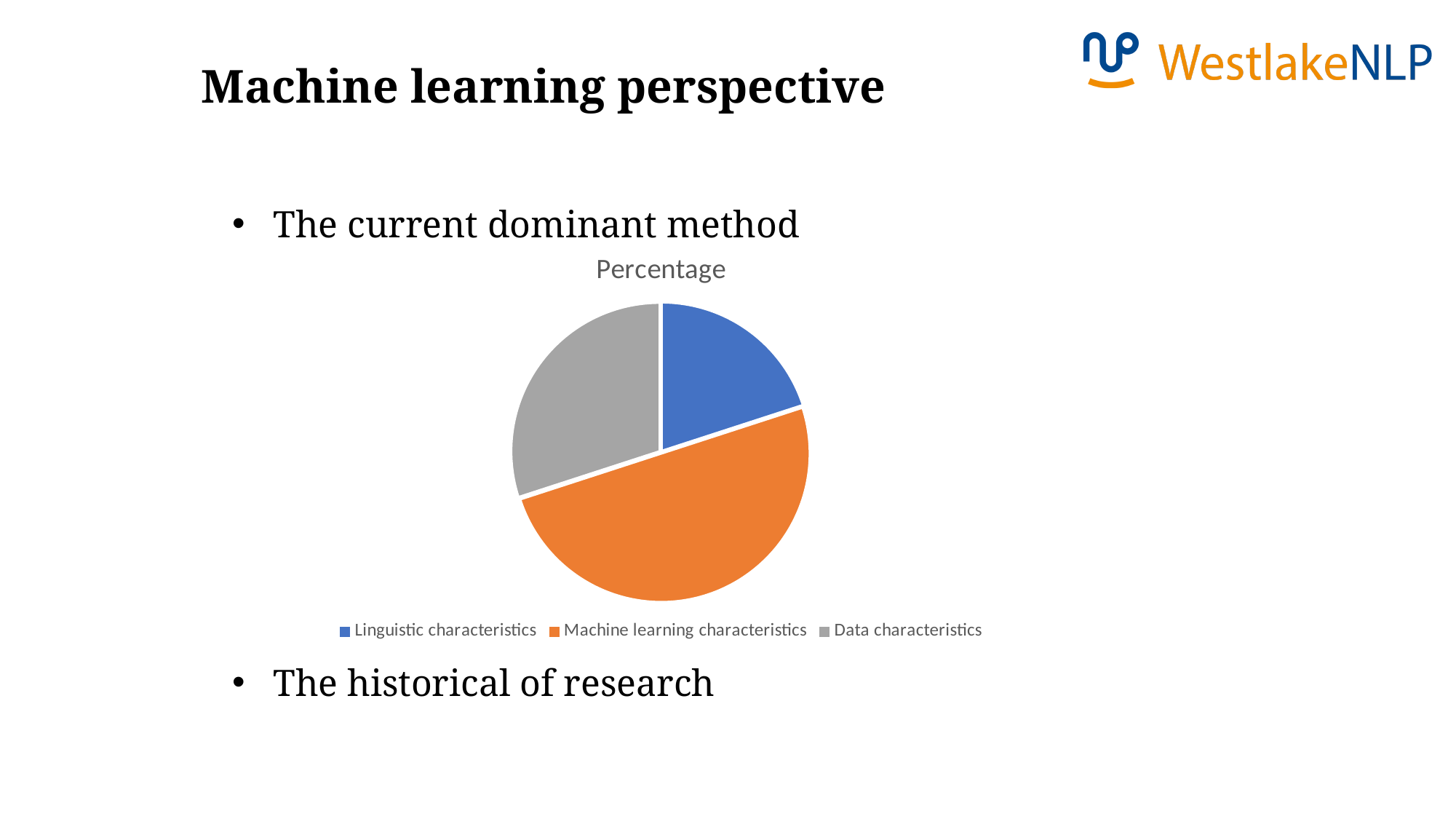
Which category has the largest slice of the pie? Machine learning characteristics What is the title of the chart? Percentage Which colour represents Machine learning characteristics in the pie chart? orange What kind of chart is shown on the slide? pie chart Which slice is larger, Machine learning characteristics or Data characteristics? Machine learning characteristics How many entries does the chart legend list? 3 Which slice is larger, Data characteristics or Linguistic characteristics? Data characteristics How many slices does the pie chart have? 3 Which category has the smallest slice of the pie? Linguistic characteristics